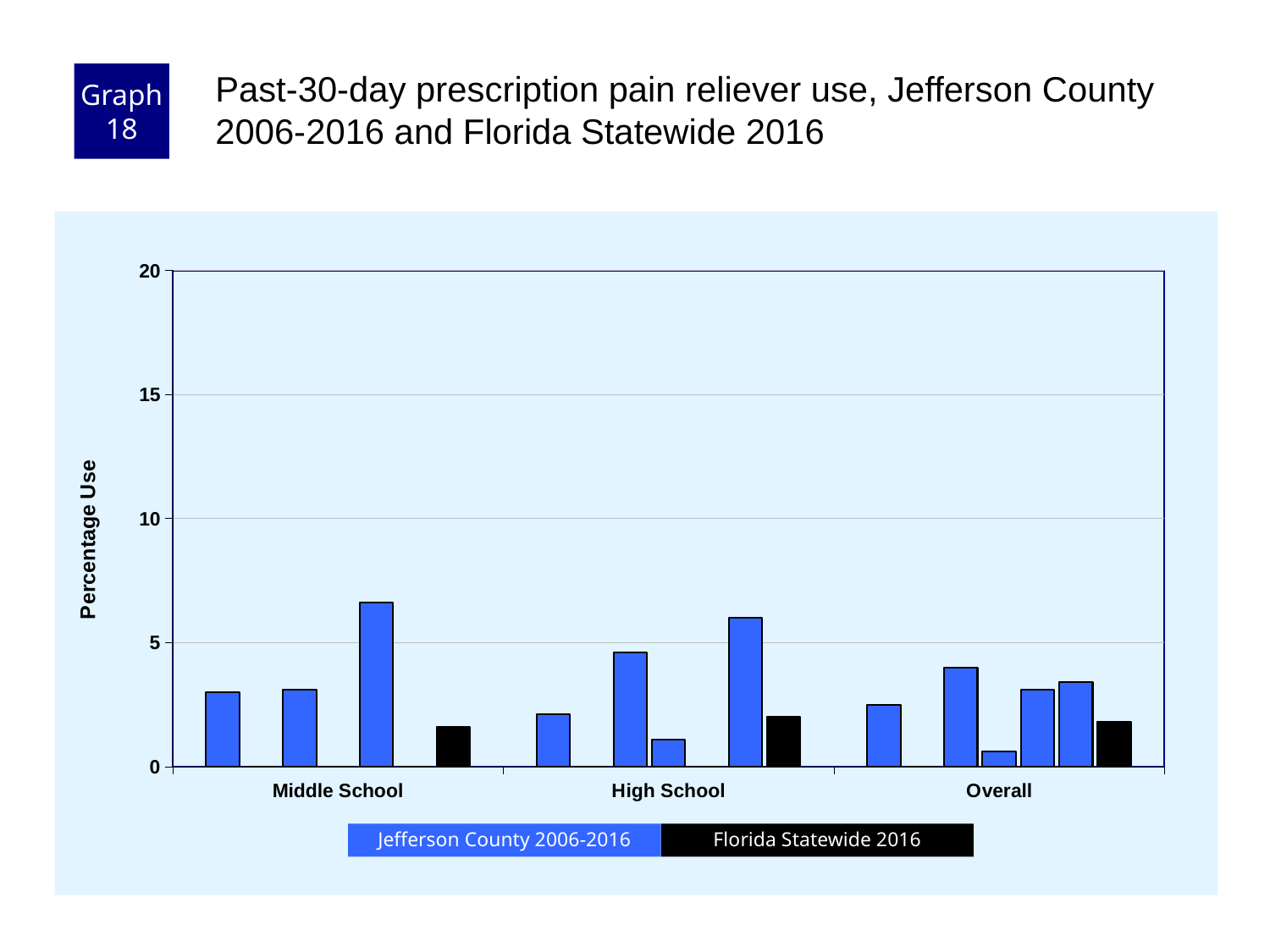
What is the title of the y axis? Percentage Use How many categories are shown on the x axis? 3 In the Overall group, is the Florida Statewide 2016 bar taller or shorter than the tallest Jefferson County 2006-2016 bar? shorter Is the tallest Jefferson County 2006-2016 bar in the Middle School group greater or less than 5? greater Is the Florida Statewide 2016 value for Middle School greater or less than 5? less Is the highest value on the chart greater or less than 10? less Which category group contains the tallest bar on the chart? Middle School How many series does the legend list? 2 What kind of chart is shown on the slide? Bar chart Is the Florida Statewide 2016 bar for High School taller or shorter than the Florida Statewide 2016 bar for Middle School? taller